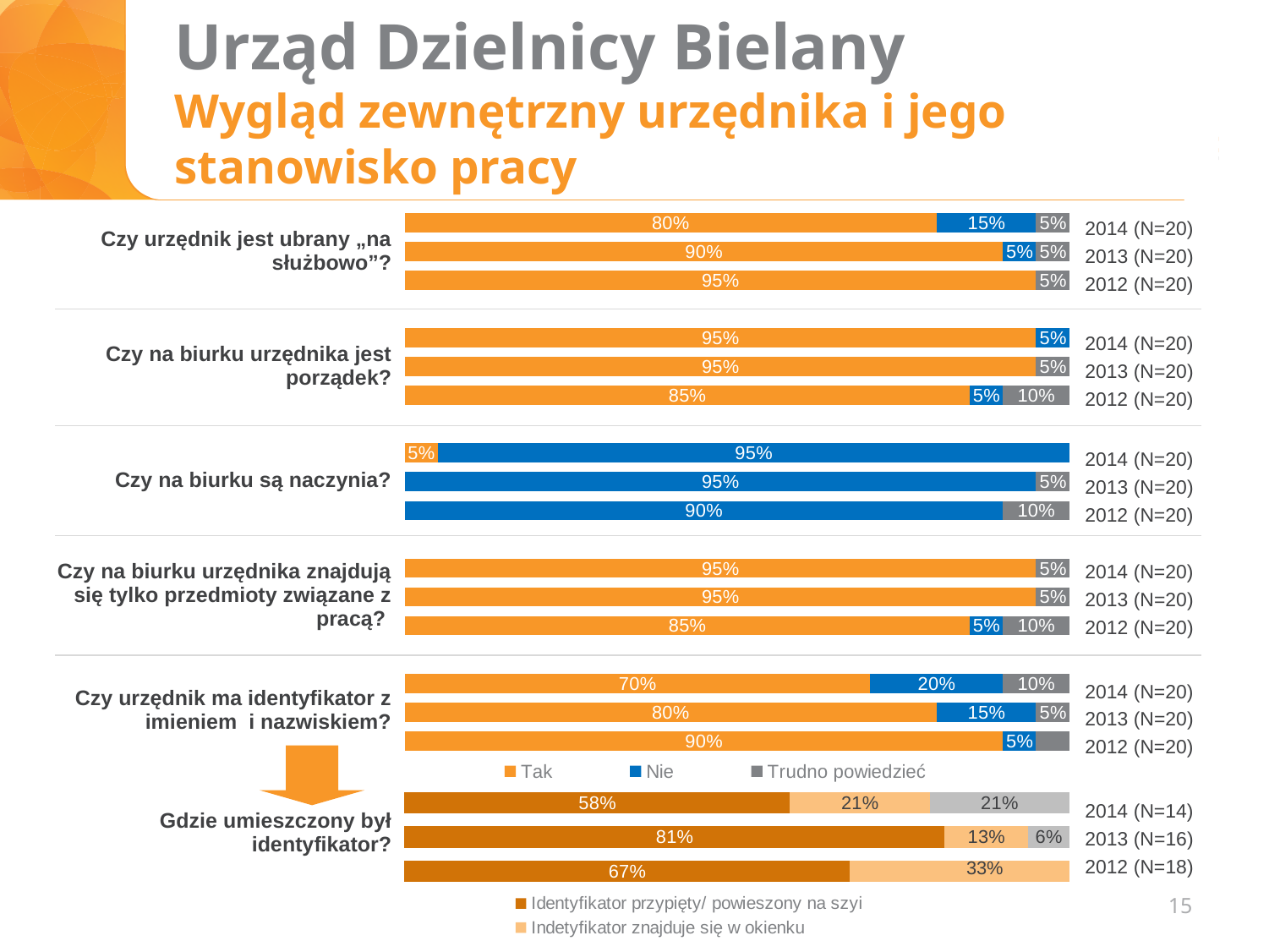
What type of chart is used on this slide? stacked bar chart In the chart "Czy urzędnik ma identyfikator z imieniem i nazwiskiem?", what is the "Nie" value for 2014 (N=20)? 20% In the chart "Gdzie umieszczony był identyfikator?", which year has the lowest value for "Identyfikator przypięty/ powieszony na szyi"? 2014 (N=14) In the chart "Czy na biurku są naczynia?", what is the "Nie" value for 2012 (N=20)? 90% In the chart "Gdzie umieszczony był identyfikator?", what is the value for "Identyfikator przypięty/ powieszony na szyi" in 2013 (N=16)? 81% In the chart "Czy urzędnik ma identyfikator z imieniem i nazwiskiem?", does the "Tak" value rise or fall from 2012 to 2014? fall In the chart "Czy na biurku są naczynia?", what is the "Tak" value for 2014 (N=20)? 5% In the chart "Czy na biurku urzędnika jest porządek?", what is the "Tak" value for 2012 (N=20)? 85% In the chart "Czy na biurku urzędnika jest porządek?", what is the difference between the "Tak" values for 2014 (N=20) and 2012 (N=20)? 10% In the chart "Czy urzędnik jest ubrany „na służbowo”?", which year has the highest "Tak" value? 2012 (N=20) In the chart "Czy urzędnik jest ubrany „na służbowo”?", what is the "Nie" value for 2014 (N=20)? 15% In the chart "Czy urzędnik jest ubrany „na służbowo”?", what is the "Tak" value for 2014 (N=20)? 80%